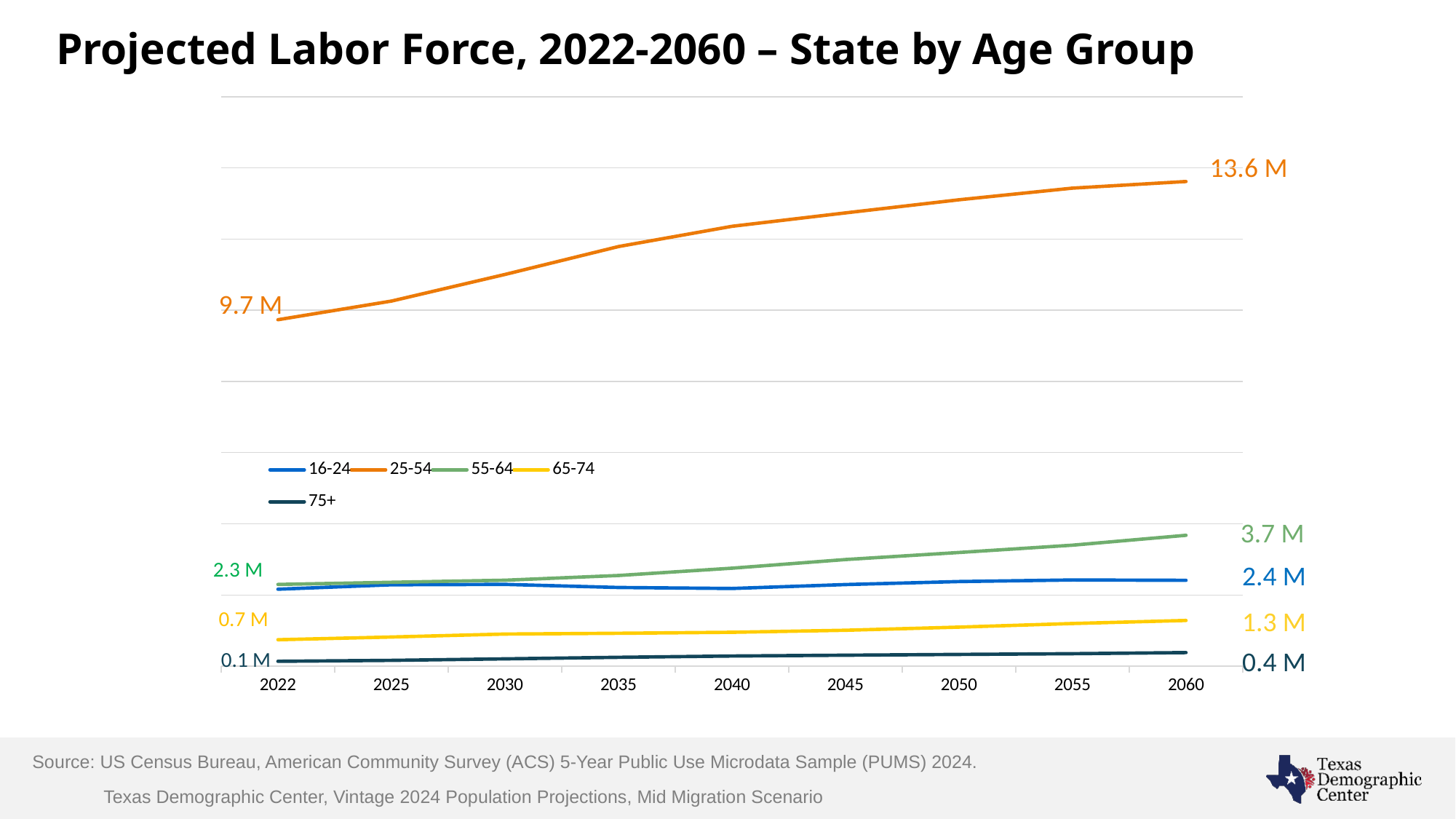
Which age group has the smallest projected labor force in 2060? 75+ By how much does the 25-54 age group's labor force grow from 2022 to 2060? 3.9 M Does the labor force for the 25-54 age group rise or fall from 2022 to 2060? rise What is the labor force for the 75+ age group in 2022? 0.1 M What is the projected labor force for the 65-74 age group in 2060? 1.3 M How many age groups does the legend list? 5 What is the projected labor force for the 25-54 age group in 2060? 13.6 M What is the projected labor force for the 16-24 age group in 2060? 2.4 M Which age group has the largest projected labor force in 2060? 25-54 What is the projected labor force for the 55-64 age group in 2060? 3.7 M What is the labor force for the 25-54 age group in 2022? 9.7 M What kind of chart is shown on the slide? line chart